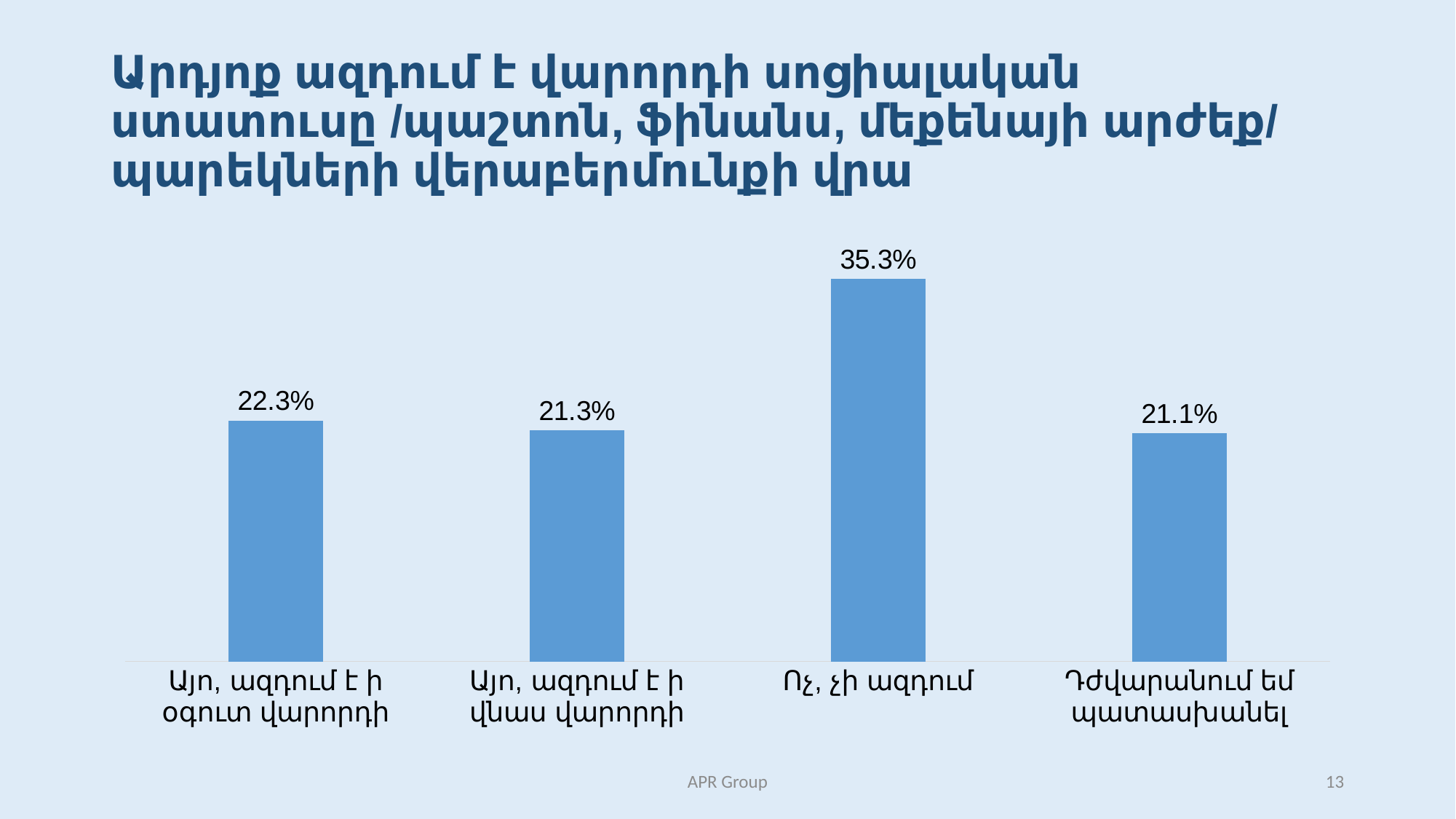
Which is larger: the value for "Այո, ազդում է ի օգուտ վարորդի" or the value for "Այո, ազդում է ի վնաս վարորդի"? Այո, ազդում է ի օգուտ վարորդի What is the value for "Դժվարանում եմ պատասխանել"? 21.1% Which category has the highest value? Ոչ, չի ազդում What is the difference between the values for "Այո, ազդում է ի օգուտ վարորդի" and "Այո, ազդում է ի վնաս վարորդի"? 1.0% Which category has the lowest value? Դժվարանում եմ պատասխանել What kind of chart is shown on the slide? Bar chart What is the value for "Այո, ազդում է ի վնաս վարորդի"? 21.3% What is the total of all four values shown in the chart? 100.0% What is the value for "Այո, ազդում է ի օգուտ վարորդի"? 22.3% What is the difference between the values for "Ոչ, չի ազդում" and "Այո, ազդում է ի օգուտ վարորդի"? 13.0% What is the value for "Ոչ, չի ազդում"? 35.3% How many categories are shown in the chart? 4